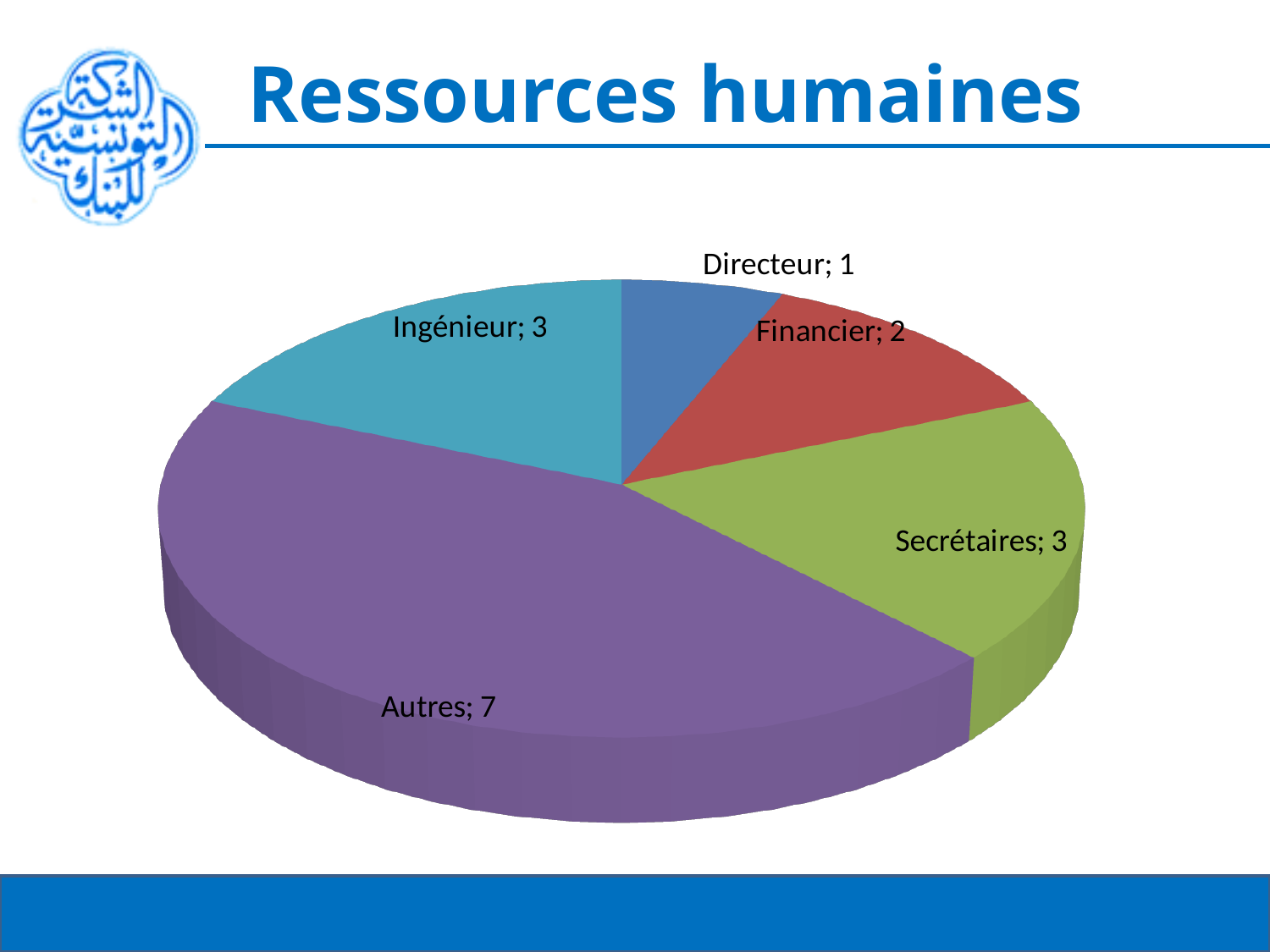
What value is shown for Directeur in the pie chart? 1 Which is larger, the value for Secrétaires or the value for Financier? Secrétaires What is the difference between the values for Autres and Secrétaires? 4 How many categories are shown in the pie chart? 5 Which category has the largest slice of the pie chart? Autres Which category has the smallest slice of the pie chart? Directeur What kind of chart is shown on the slide? Pie chart What value is shown for Autres in the pie chart? 7 What is the difference between the values for Financier and Directeur? 1 What share of the total does the Autres slice represent? 43.75% What is the title of the slide containing the pie chart? Ressources humaines What value is shown for Financier in the pie chart? 2